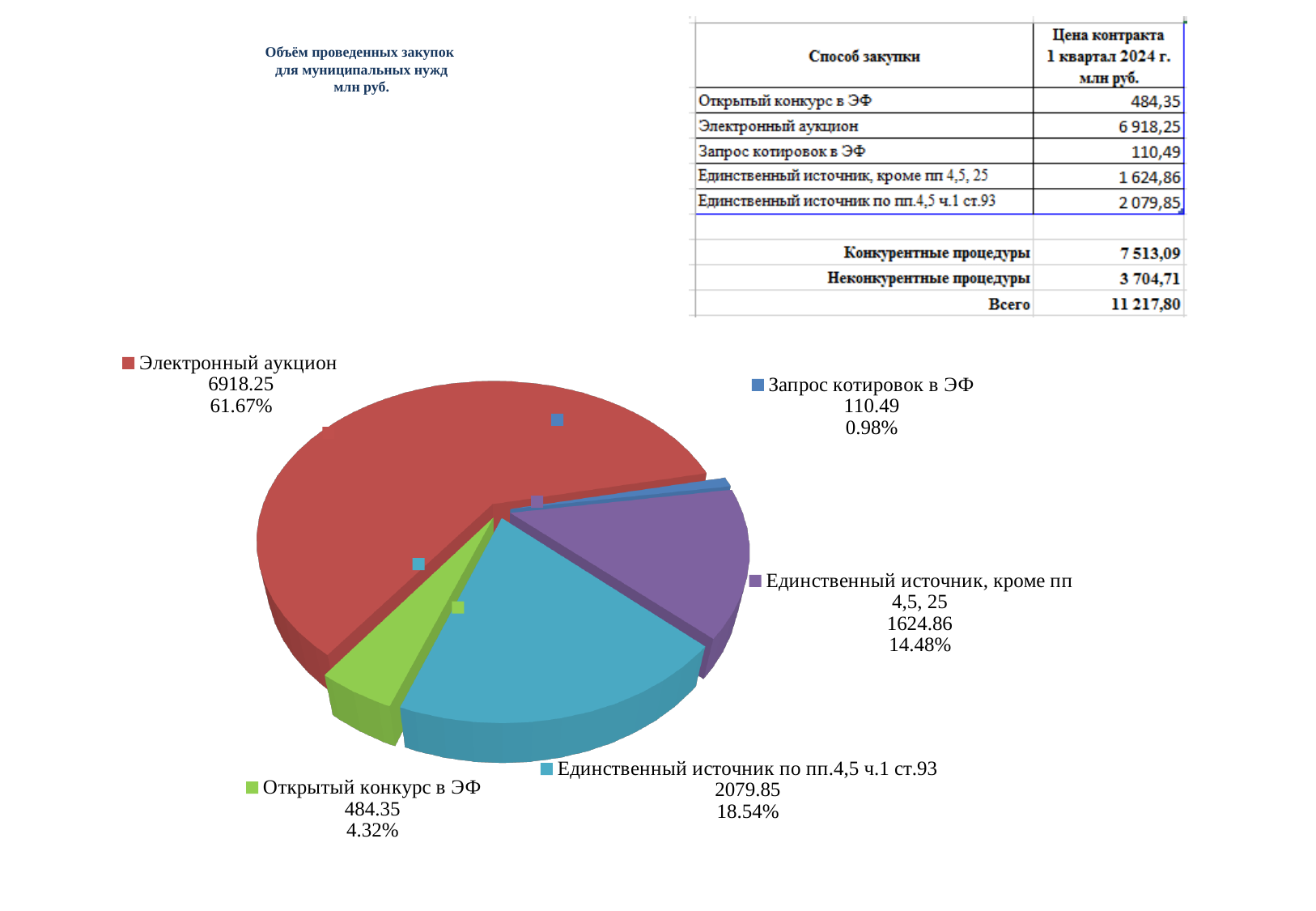
What kind of chart is shown on the slide? pie chart What percentage share does Единственный источник, кроме пп 4,5, 25 have in the pie chart? 14.48% Which category has the smallest slice in the pie chart? Запрос котировок в ЭФ What is the value shown for Единственный источник по пп.4,5 ч.1 ст.93 in the pie chart? 2079.85 What is the title of the pie chart? Объём проведенных закупок для муниципальных нужд млн руб. Which category has the largest slice in the pie chart? Электронный аукцион What is the difference between the values for Единственный источник по пп.4,5 ч.1 ст.93 and Единственный источник, кроме пп 4,5, 25 in the pie chart? 454.99 Which is larger in the pie chart: Открытый конкурс в ЭФ or Единственный источник, кроме пп 4,5, 25? Единственный источник, кроме пп 4,5, 25 What colour is the slice for Открытый конкурс в ЭФ in the pie chart? green What percentage share does Запрос котировок в ЭФ have in the pie chart? 0.98% What is the value shown for Электронный аукцион in the pie chart? 6918.25 How many slices does the pie chart have? 5